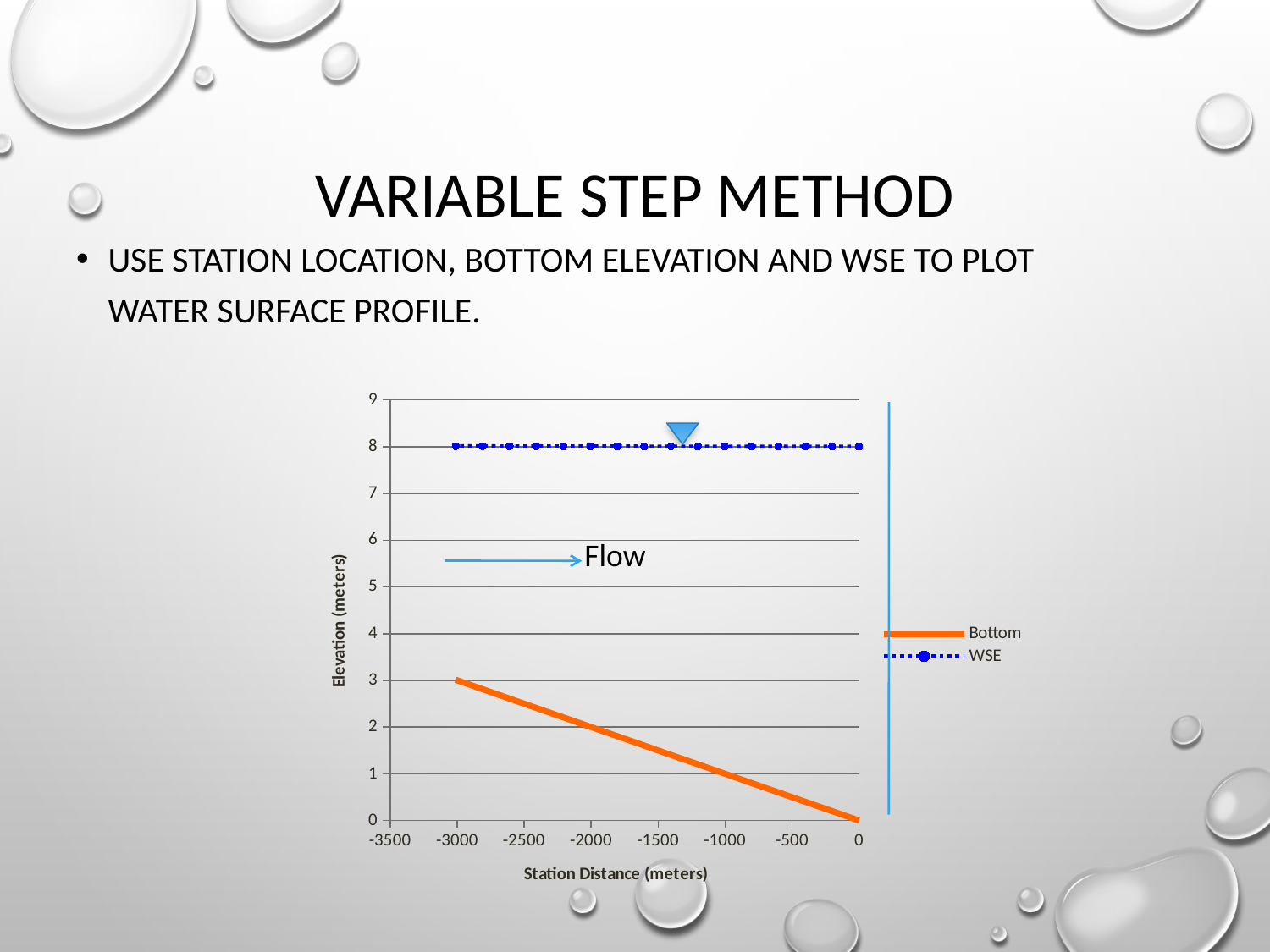
At station distance -3000, which series has the higher elevation, WSE or Bottom? WSE What is the Bottom elevation at station distance -3000? 3 What is the title of the chart's x axis? Station Distance (meters) Does the WSE series rise, fall or stay flat across the station distances? stays flat What kind of chart is shown on the slide? line chart What is the WSE elevation at station distance 0? 8 Is the Bottom elevation at station distance -1500 greater or less than 2? less At station distance -3000, what is the difference between the WSE elevation and the Bottom elevation? 5 How many series does the chart's legend list? 2 What are the two series named in the chart's legend? Bottom and WSE Does the Bottom series rise or fall as station distance goes from -3000 to 0? falls What is the Bottom elevation at station distance 0? 0